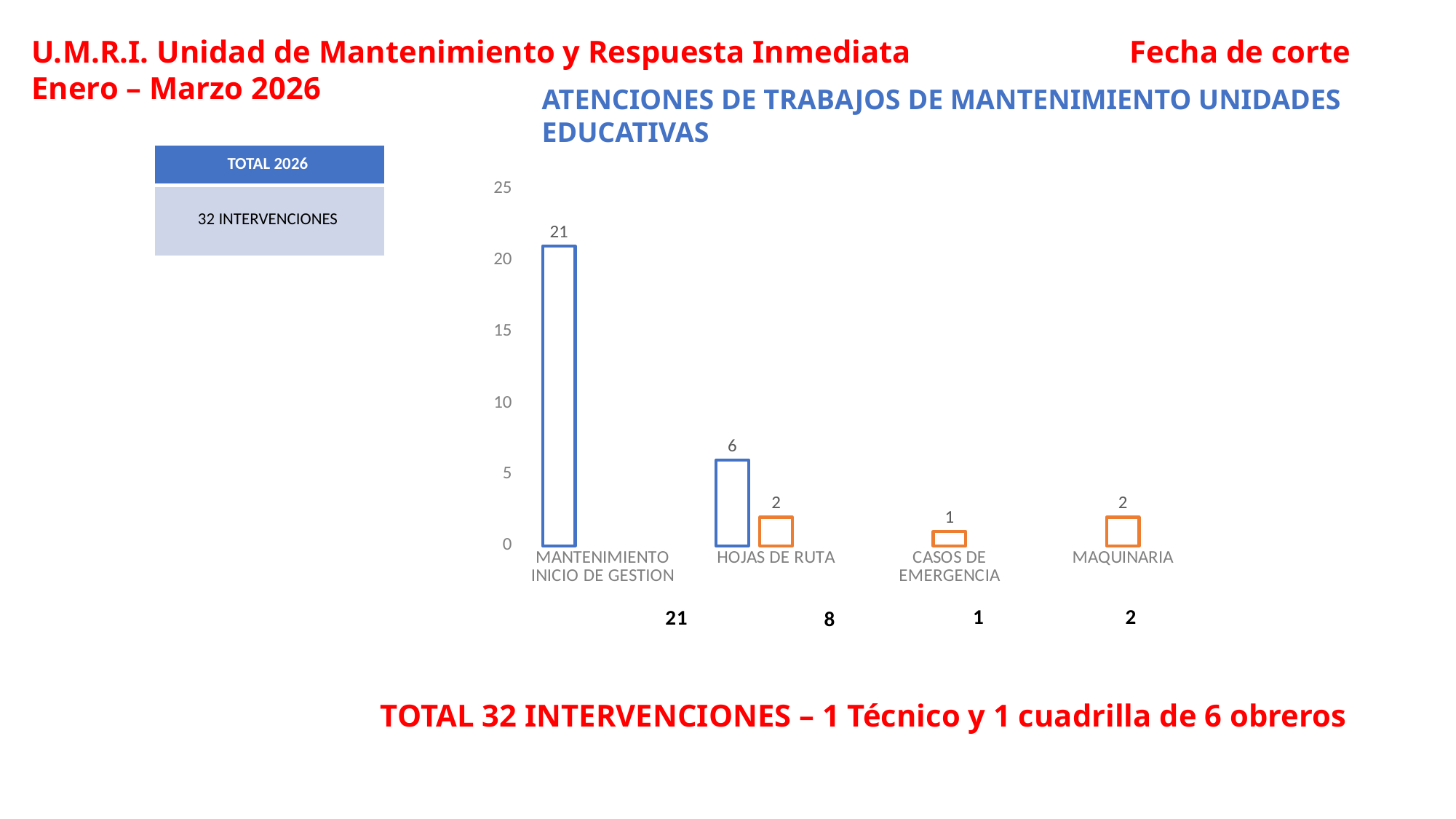
What is the value of the blue bar for MANTENIMIENTO INICIO DE GESTION? 21 Which category has the lowest bar in the chart? CASOS DE EMERGENCIA What is the value shown for CASOS DE EMERGENCIA? 1 Which is larger: the blue bar for HOJAS DE RUTA or the bar for MAQUINARIA? HOJAS DE RUTA What is the difference between the blue bar for MANTENIMIENTO INICIO DE GESTION and the blue bar for HOJAS DE RUTA? 15 Which category has the highest bar in the chart? MANTENIMIENTO INICIO DE GESTION How many categories are shown on the x axis of the chart? 4 What is the value of the blue bar for HOJAS DE RUTA? 6 What type of chart is shown on the slide? bar chart What is the value shown for MAQUINARIA? 2 What is the title of the chart? ATENCIONES DE TRABAJOS DE MANTENIMIENTO UNIDADES EDUCATIVAS What is the value of the orange bar for HOJAS DE RUTA? 2